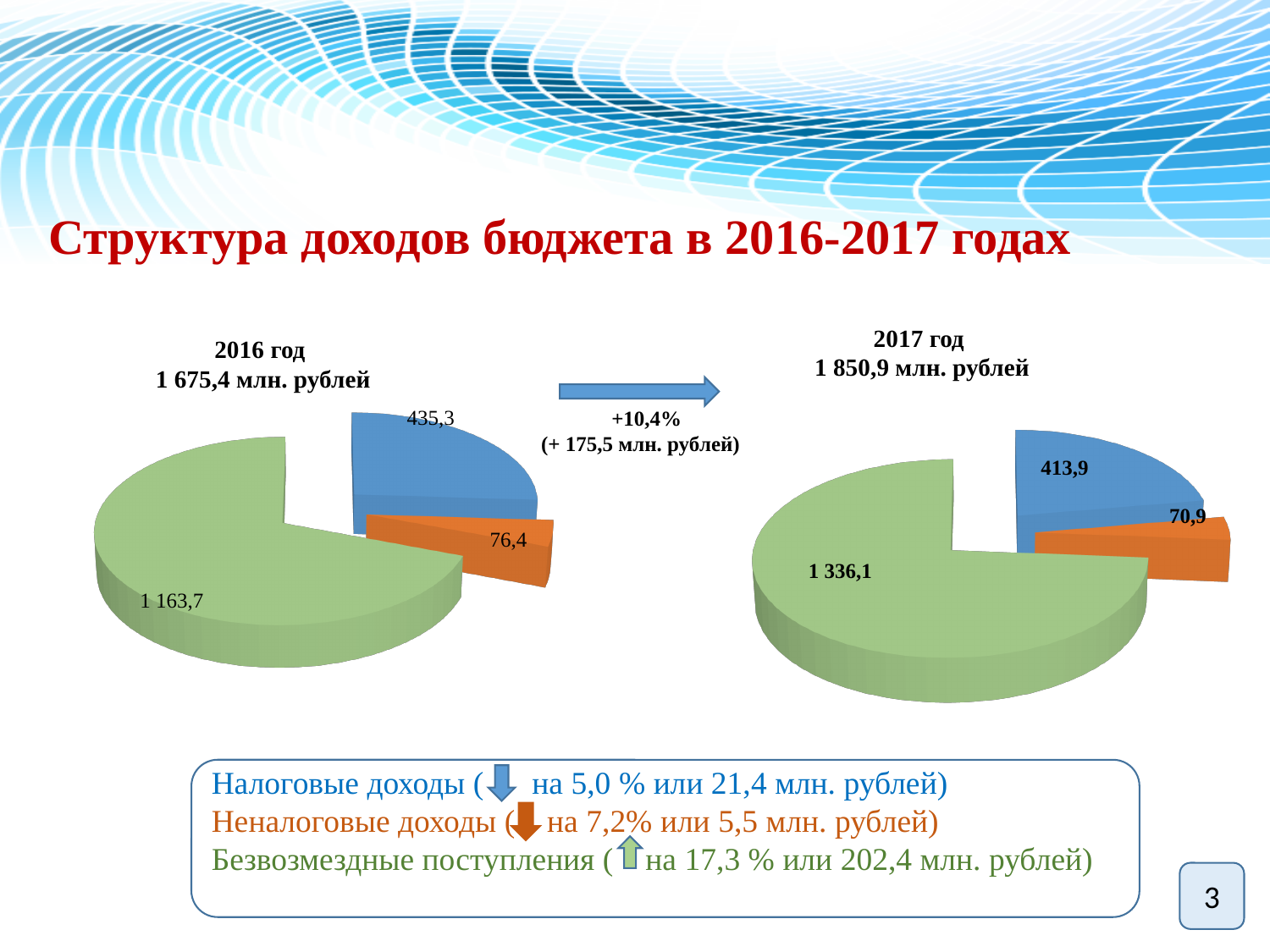
How many slices does the 2017 pie chart have? 3 Which is larger: the green slice in 2016 or the green slice in 2017? 2017 (1 336,1) On the 2017 pie chart, what is the difference between the blue slice and the orange slice? 343,0 On the 2017 pie chart, what is the value of the green slice? 1 336,1 On the 2016 pie chart, what is the value of the blue slice? 435,3 On the 2016 pie chart, what is the difference between the blue slice and the orange slice? 358,9 What type of chart is used for the 2016 data? pie chart What total is shown above the 2017 pie chart? 1 850,9 млн. рублей On the 2016 pie chart, which slice has the largest value? green (1 163,7) What percentage change is shown on the arrow between the two pie charts? +10,4% On the 2017 pie chart, what is the value of the orange slice? 70,9 On the 2017 pie chart, which slice has the smallest value? orange (70,9)